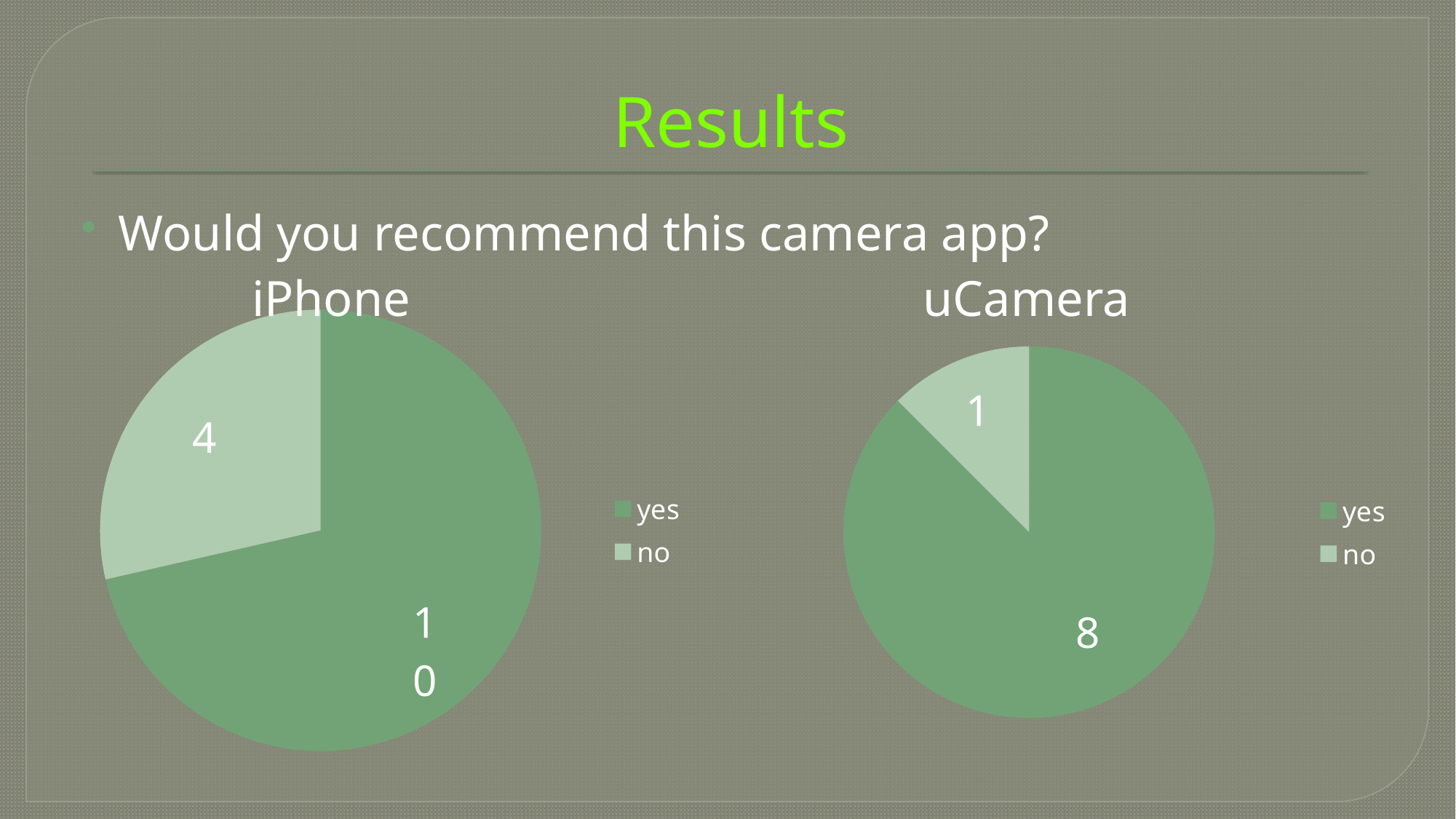
In the uCamera chart, how many respondents answered "no"? 1 How many slices does the uCamera pie chart have? 2 In the uCamera chart, how many respondents answered "yes"? 8 In the uCamera chart, which category is the largest? yes In the iPhone chart, how many respondents answered "no"? 4 Which chart has the larger "no" count, iPhone or uCamera? iPhone In the iPhone chart, which category is the smallest? no In the uCamera chart, what is the difference between the "yes" and "no" counts? 7 In the uCamera chart, what is the total number of responses across both slices? 9 How many entries does the legend of the iPhone chart list? 2 What kind of chart is the iPhone chart? pie chart In the iPhone chart, how many respondents answered "yes"? 10